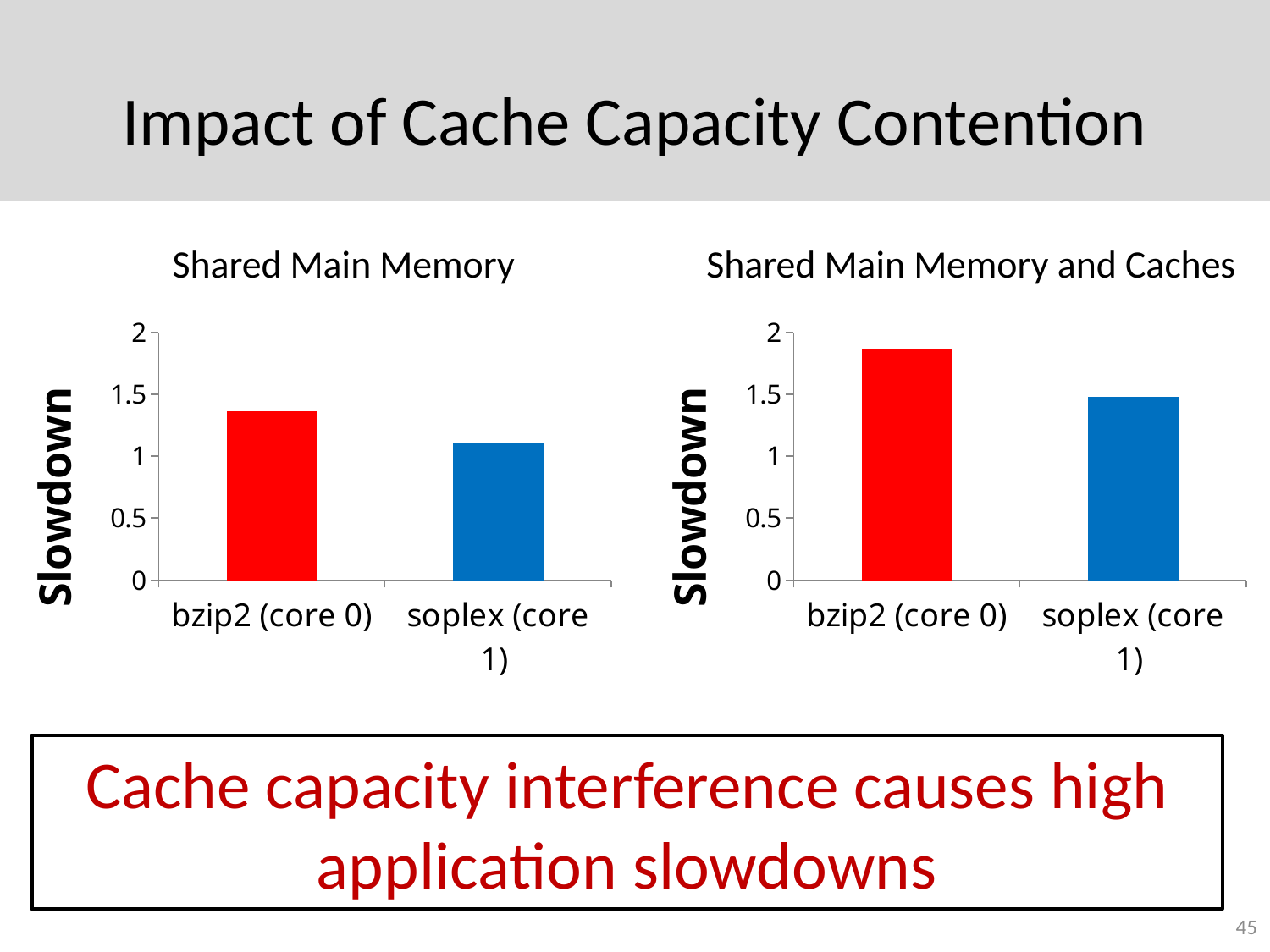
What type of chart is the "Shared Main Memory" chart? bar chart In the "Shared Main Memory" chart, which category has the highest slowdown? bzip2 (core 0) In the "Shared Main Memory and Caches" chart, is the slowdown for soplex (core 1) greater or less than 1? greater In the "Shared Main Memory" chart, is the slowdown for bzip2 (core 0) greater or less than 1.5? less In the "Shared Main Memory" chart, what colour is the bar for bzip2 (core 0)? red What is the y-axis label of the "Shared Main Memory and Caches" chart? Slowdown In the "Shared Main Memory and Caches" chart, which has the larger slowdown, bzip2 (core 0) or soplex (core 1)? bzip2 (core 0) In the "Shared Main Memory" chart, is the slowdown for bzip2 (core 0) greater or less than 1? greater In the "Shared Main Memory and Caches" chart, which category has the lowest slowdown? soplex (core 1) How many categories are shown in the "Shared Main Memory" chart? 2